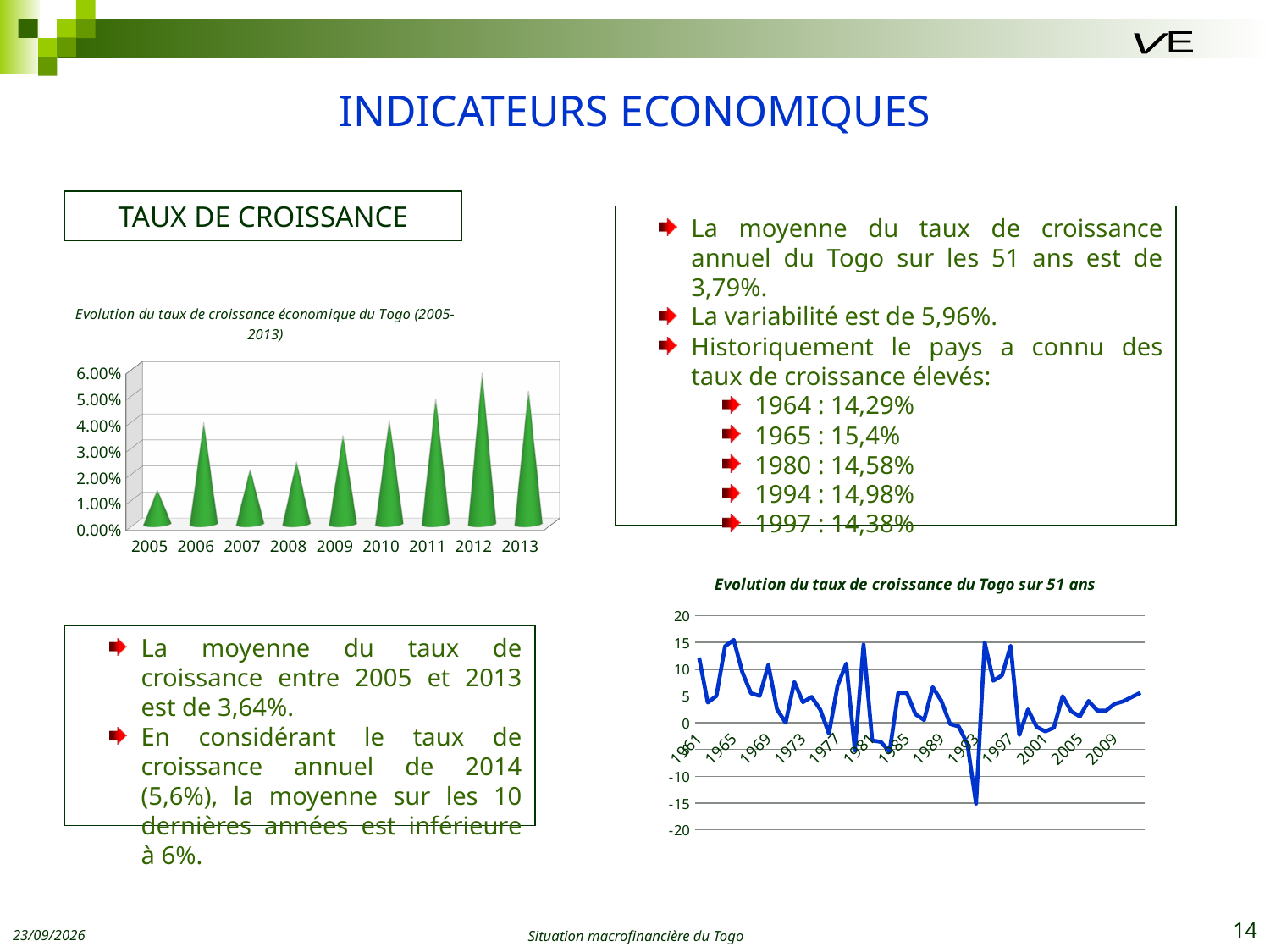
In the chart 'Evolution du taux de croissance économique du Togo (2005-2013)', which year has the larger value, 2006 or 2007? 2006 In the chart 'Evolution du taux de croissance économique du Togo (2005-2013)', which year has the highest growth rate? 2012 In the chart 'Evolution du taux de croissance du Togo sur 51 ans', is the value for 1993 greater or less than -10? less In the chart 'Evolution du taux de croissance économique du Togo (2005-2013)', how many years are plotted? 9 In the chart 'Evolution du taux de croissance économique du Togo (2005-2013)', which year has the larger value, 2011 or 2013? 2013 In the chart 'Evolution du taux de croissance économique du Togo (2005-2013)', which year has the lowest growth rate? 2005 In the chart 'Evolution du taux de croissance économique du Togo (2005-2013)', is the value for 2012 greater or less than 5.00%? greater In the chart 'Evolution du taux de croissance économique du Togo (2005-2013)', is the value for 2005 greater or less than 2.00%? less In the chart 'Evolution du taux de croissance économique du Togo (2005-2013)', what kind of chart is used? Bar chart In the chart 'Evolution du taux de croissance du Togo sur 51 ans', what is the highest value shown on the vertical axis? 20 In the chart 'Evolution du taux de croissance du Togo sur 51 ans', what kind of chart is used? Line chart